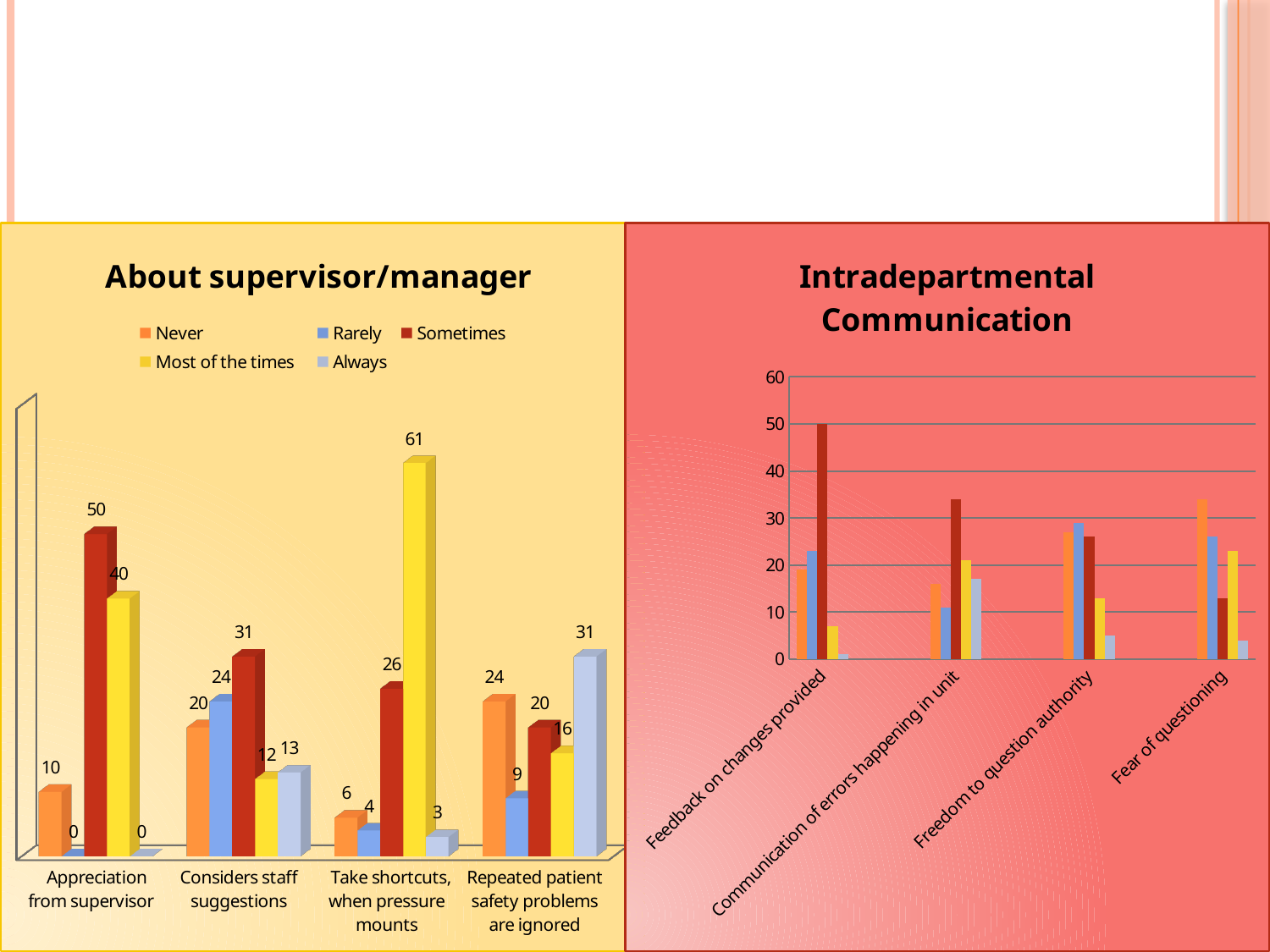
In the About supervisor/manager chart, which category has the lowest value for Most of the times? Considers staff suggestions In the About supervisor/manager chart, which category has the highest value for Never? Repeated patient safety problems are ignored In the About supervisor/manager chart, what is the value for Always for Repeated patient safety problems are ignored? 31 How many categories are shown on the x axis of the Intradepartmental Communication chart? 4 In the About supervisor/manager chart, which is larger for Considers staff suggestions: Never or Rarely? Rarely In the About supervisor/manager chart, what is the value for Sometimes for Appreciation from supervisor? 50 In the Intradepartmental Communication chart, is the tallest bar for Freedom to question authority greater or less than 40? less In the About supervisor/manager chart, what is the difference between the Sometimes and Most of the times values for Appreciation from supervisor? 10 In the Intradepartmental Communication chart, is the tallest bar for Feedback on changes provided greater or less than 40? greater What kind of chart is the Intradepartmental Communication chart? Bar chart In the About supervisor/manager chart, what is the value for Most of the times for Take shortcuts, when pressure mounts? 61 How many series does the legend of the About supervisor/manager chart list? 5